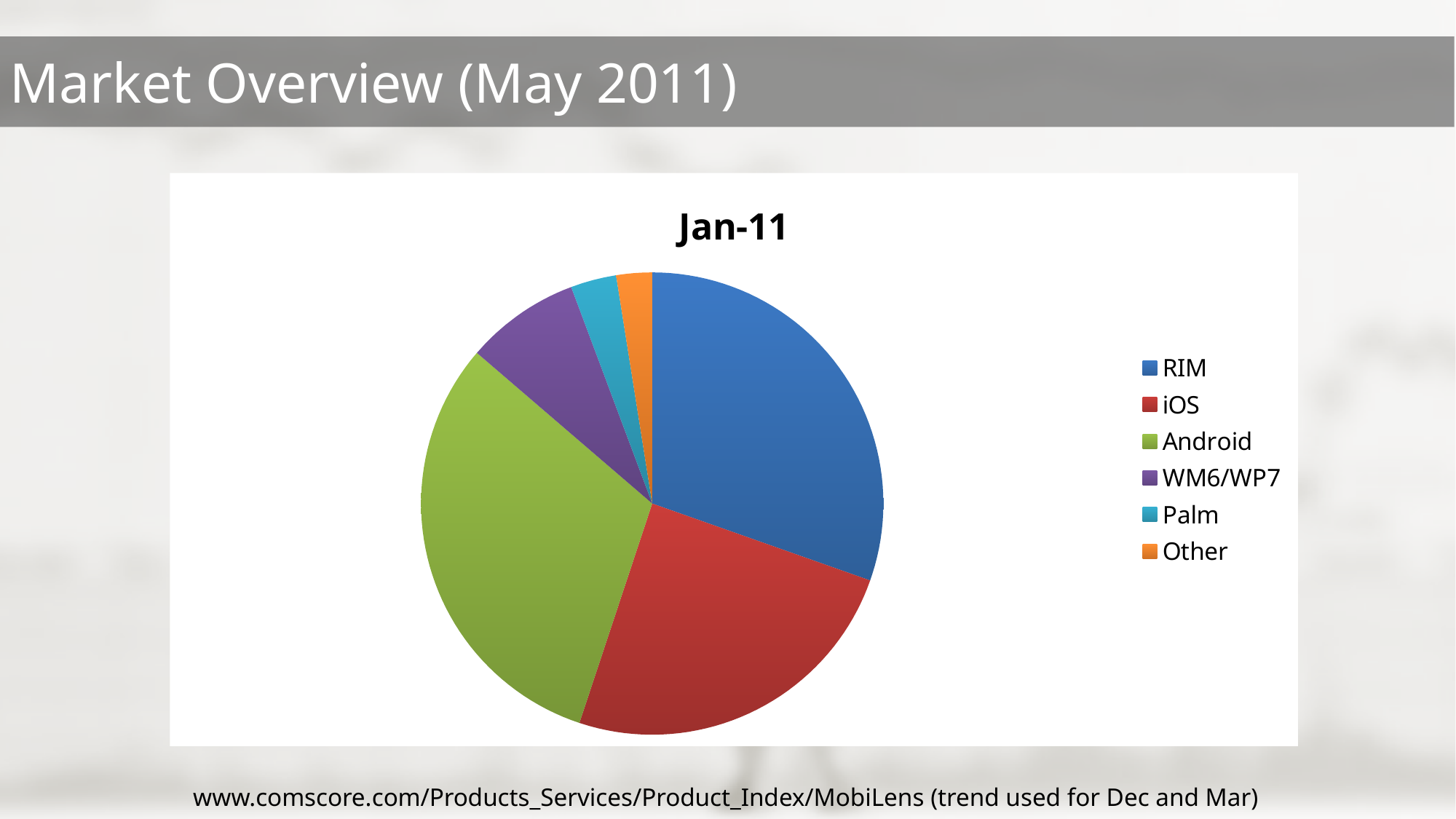
Which slice is larger in the pie chart, Android or iOS? Android What is the title of the pie chart? Jan-11 How many slices does the pie chart have? 6 What kind of chart is shown on the slide? pie chart Which slice is larger in the pie chart, WM6/WP7 or Palm? WM6/WP7 How many categories does the legend of the pie chart list? 6 Which slice is larger in the pie chart, RIM or iOS? RIM Which colour represents Android in the pie chart? green